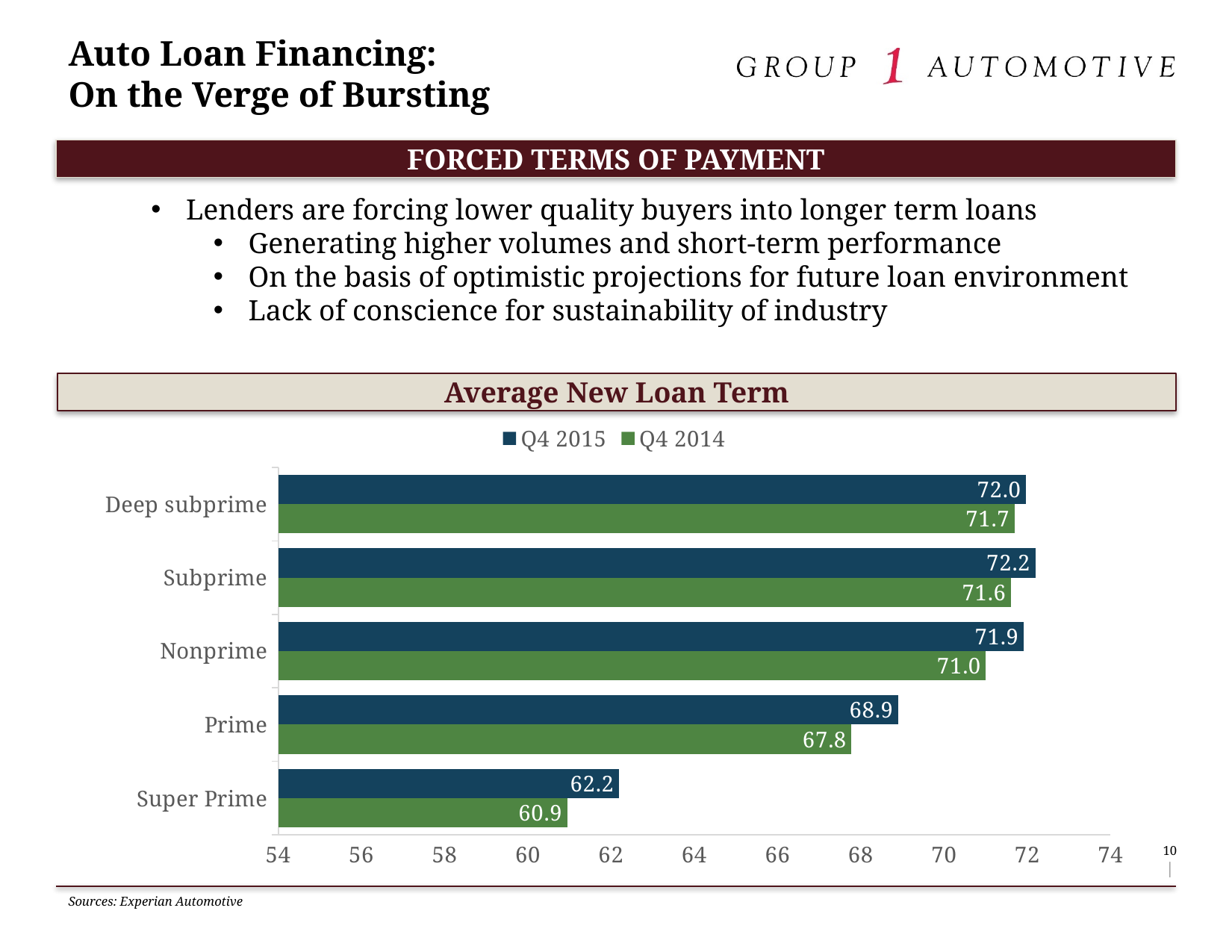
Which category has the lowest Q4 2014 value? Super Prime What is the title of the chart? Average New Loan Term Which is larger, the Q4 2015 value for Nonprime or the Q4 2015 value for Prime? Nonprime How many categories are shown on the chart? 5 How many series does the legend list? 2 What is the Q4 2015 average new loan term for Subprime? 72.2 What kind of chart is shown on the slide? Bar chart What is the difference between the Q4 2015 and Q4 2014 values for Prime? 1.1 What is the Q4 2014 average new loan term for Super Prime? 60.9 Which category has the highest Q4 2015 value? Subprime What is the difference between the Q4 2015 and Q4 2014 values for Super Prime? 1.3 What is the Q4 2014 value for Nonprime? 71.0